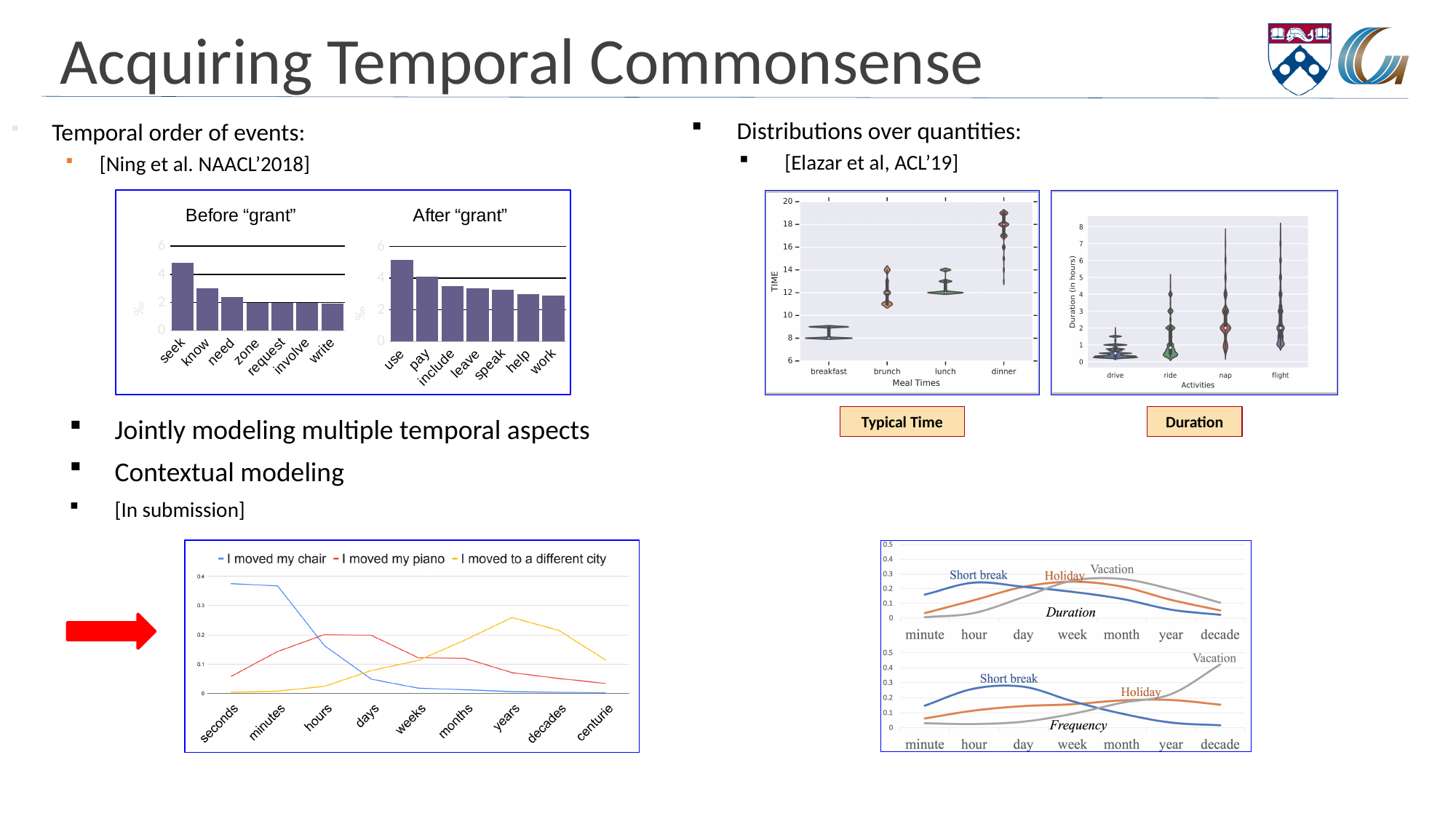
In the Before "grant" bar chart, which word has the highest bar? seek How many words are shown on the x axis of the Before "grant" bar chart? 7 What kind of chart is the Before "grant" chart? bar chart In the bottom-left line chart, how many categories are on the x axis? 9 In the bottom-left line chart, how many series does the legend list? 3 In the Before "grant" bar chart, is the value for "know" greater or less than 4? less In the bottom-left line chart, does the "I moved my chair" series rise or fall from seconds to centuries? fall In the After "grant" bar chart, is the value for "use" greater or less than 4? greater In the bottom-left line chart, which series has the highest value at "years"? I moved to a different city In the After "grant" bar chart, which word has the highest bar? use